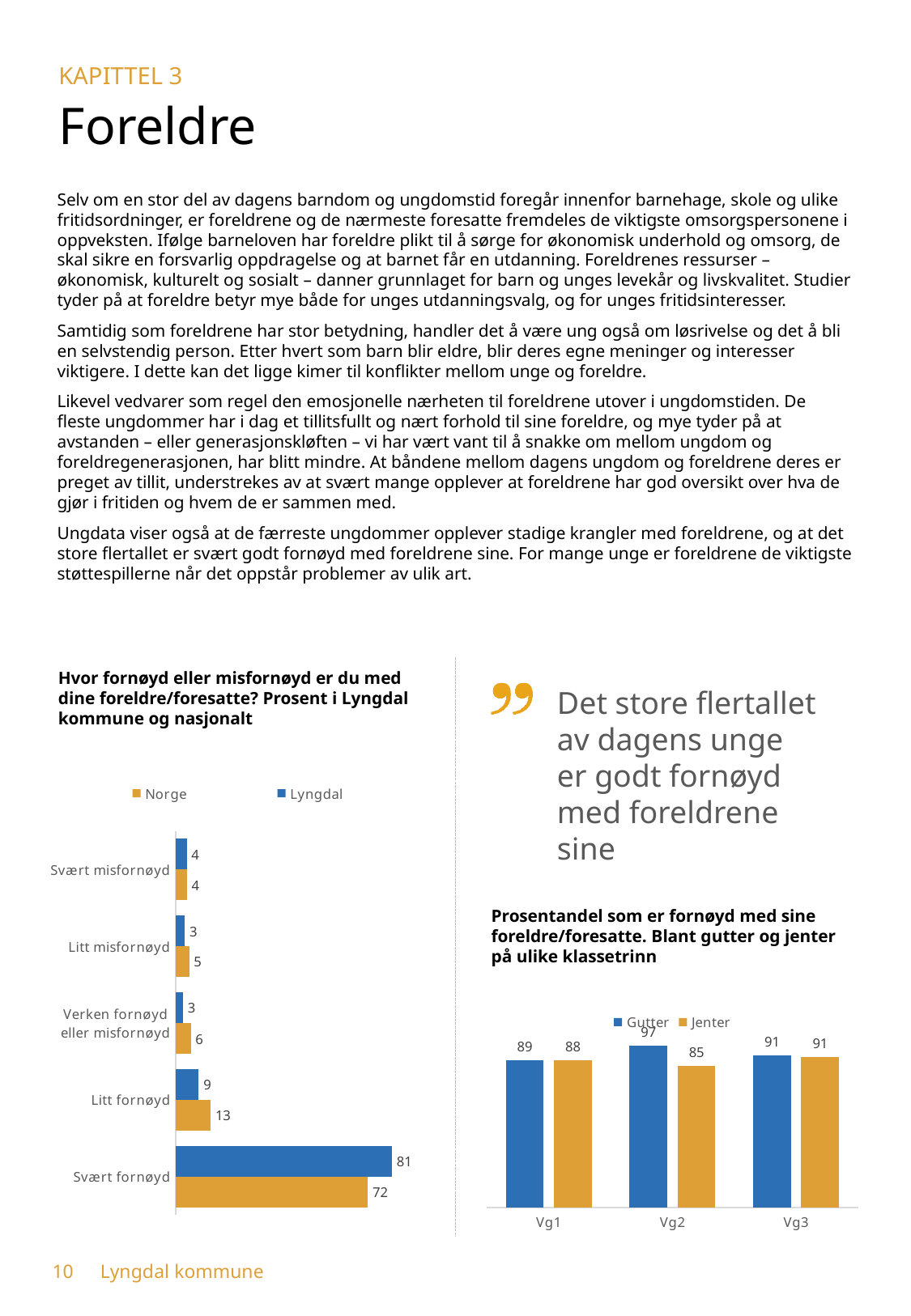
In the right chart (Prosentandel som er fornøyd med sine foreldre/foresatte), what is the Gutter value for Vg2? 97 In the left chart (Hvor fornøyd eller misfornøyd er du med dine foreldre/foresatte?), what is the Lyngdal value for Svært fornøyd? 81 What kind of chart is the right chart (Prosentandel som er fornøyd med sine foreldre/foresatte)? Bar chart In the left chart (Hvor fornøyd eller misfornøyd er du med dine foreldre/foresatte?), which category has the highest Norge value? Svært fornøyd In the left chart (Hvor fornøyd eller misfornøyd er du med dine foreldre/foresatte?), how many series does the legend list? 2 In the right chart (Prosentandel som er fornøyd med sine foreldre/foresatte), what is the difference between Gutter and Jenter at Vg2? 12 In the left chart (Hvor fornøyd eller misfornøyd er du med dine foreldre/foresatte?), which is larger for Verken fornøyd eller misfornøyd: Norge or Lyngdal? Norge In the right chart (Prosentandel som er fornøyd med sine foreldre/foresatte), what is the Jenter value for Vg3? 91 In the right chart (Prosentandel som er fornøyd med sine foreldre/foresatte), which class level has the lowest Jenter value? Vg2 In the left chart (Hvor fornøyd eller misfornøyd er du med dine foreldre/foresatte?), what is the difference between the Lyngdal and Norge values for Svært fornøyd? 9 In the left chart (Hvor fornøyd eller misfornøyd er du med dine foreldre/foresatte?), how many categories are shown? 5 In the left chart (Hvor fornøyd eller misfornøyd er du med dine foreldre/foresatte?), what is the Norge value for Litt fornøyd? 13